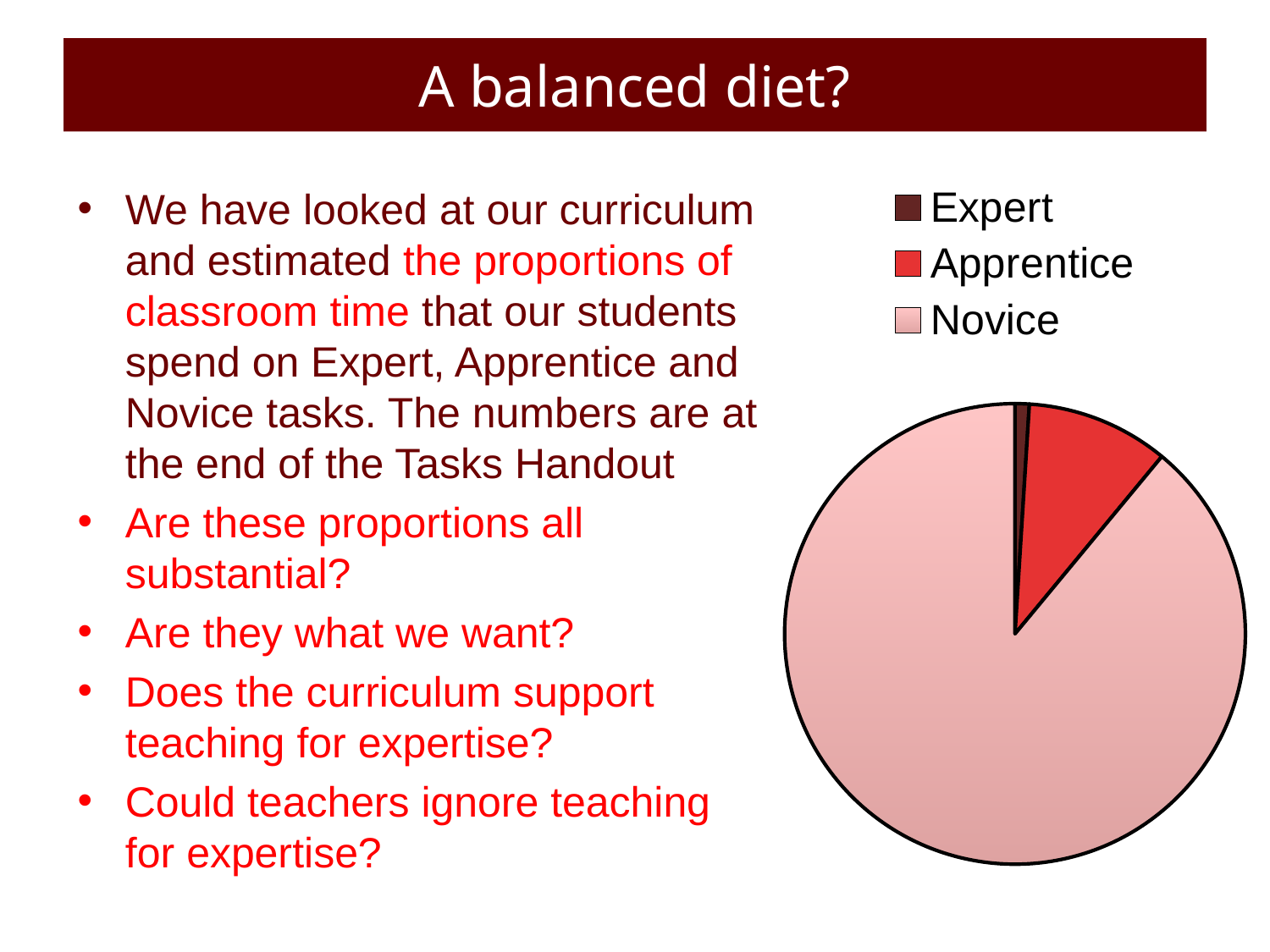
Which slice is larger in the pie chart, Apprentice or Expert? Apprentice Which slice is larger in the pie chart, Novice or Apprentice? Novice Which category has the largest slice of the pie chart? Novice What kind of chart is shown on the slide? pie chart Which category is shown in the darkest colour in the pie chart's legend? Expert Which category has the smallest slice of the pie chart? Expert Does the Novice slice take up more or less than half of the pie chart? more How many slices does the pie chart have? 3 What are the three categories listed in the pie chart's legend? Expert, Apprentice, Novice